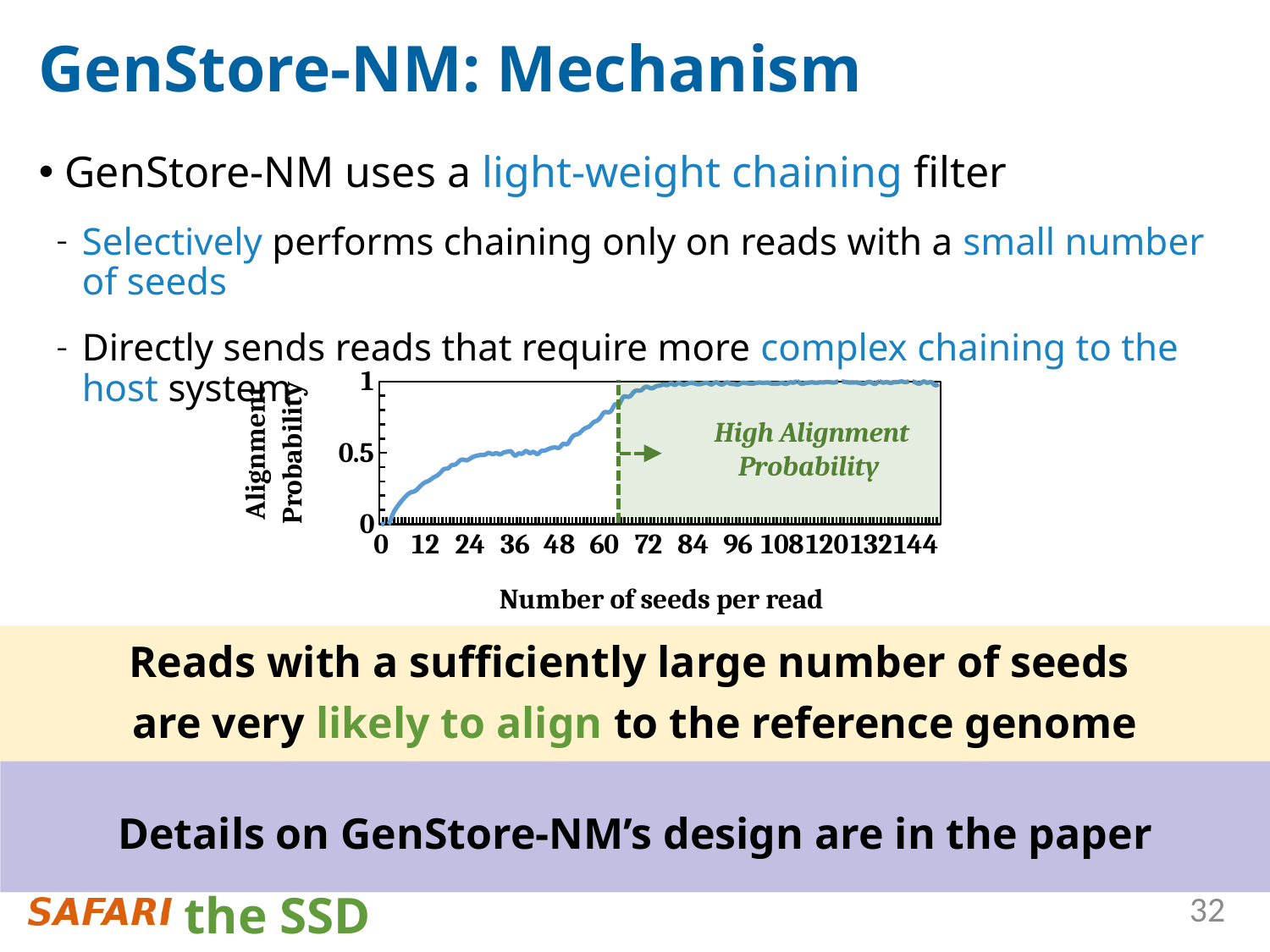
What is the largest tick value shown on the x axis of the chart? 144 Which has the higher alignment probability: 12 seeds per read or 84 seeds per read? 84 seeds per read What is the label of the y axis of the chart? Alignment Probability Is the alignment probability at 72 seeds per read greater or less than 0.5? greater What is the label of the x axis of the chart? Number of seeds per read Is the alignment probability at 12 seeds per read greater or less than 0.5? less Does the alignment probability rise or fall as the number of seeds per read increases? rise What is the highest tick value shown on the y axis of the chart? 1 Is the alignment probability at 96 seeds per read greater or less than 0.5? greater How many tick labels are shown on the x axis of the chart? 13 What kind of chart is shown on the slide? line chart How many lines are plotted in the chart? 1